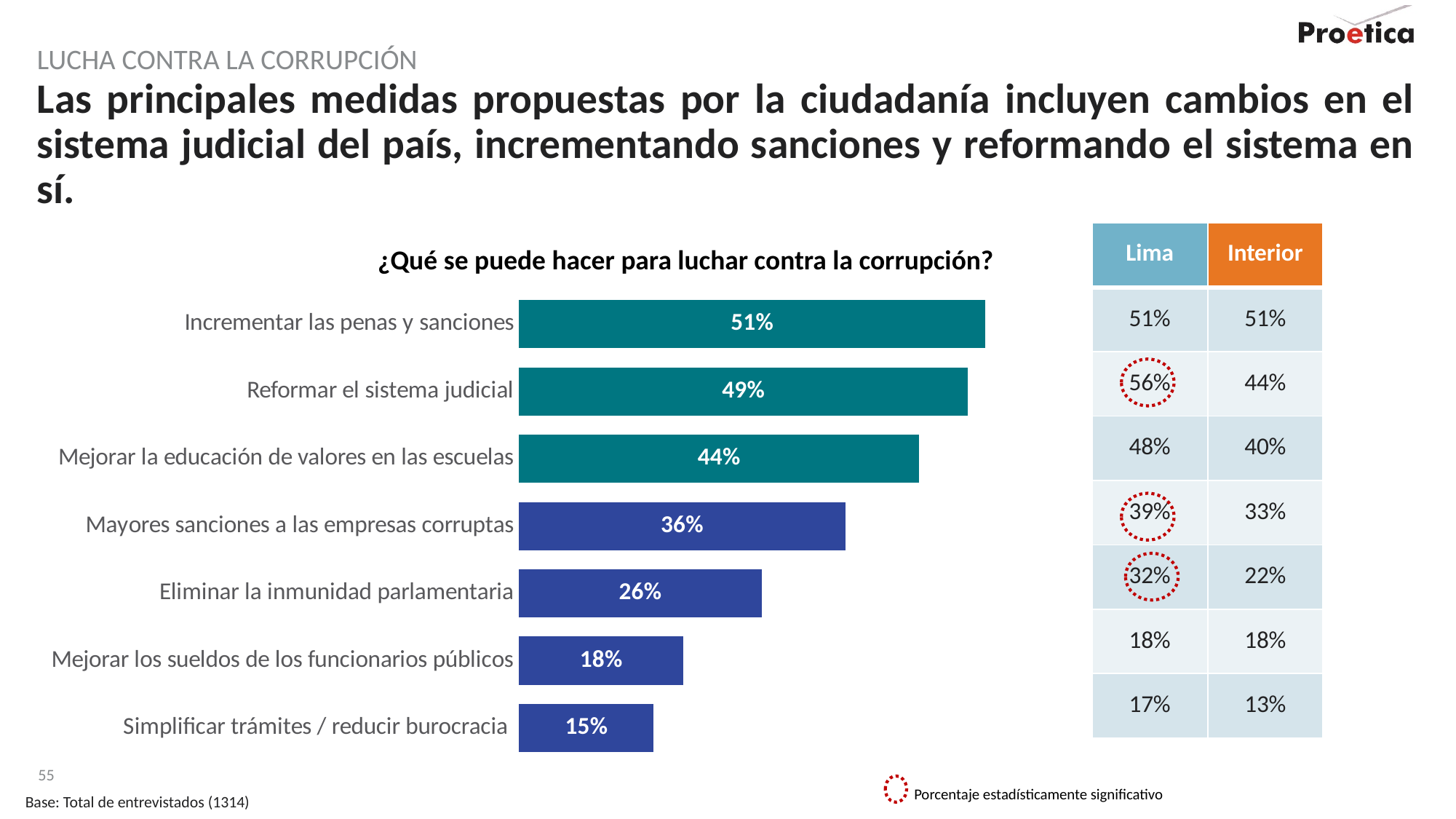
What is the title of the chart? ¿Qué se puede hacer para luchar contra la corrupción? Which category has the lowest value? Simplificar trámites / reducir burocracia Which is larger, "Eliminar la inmunidad parlamentaria" or "Mejorar los sueldos de los funcionarios públicos"? Eliminar la inmunidad parlamentaria What is the difference between "Mejorar la educación de valores en las escuelas" and "Mayores sanciones a las empresas corruptas"? 8% What is the value for "Simplificar trámites / reducir burocracia"? 15% Do the values rise or fall going from the top bar to the bottom bar? Fall What kind of chart is shown? Bar chart Which category has the highest value? Incrementar las penas y sanciones What is the value for "Reformar el sistema judicial"? 49% What is the value for "Incrementar las penas y sanciones"? 51% How many categories does the chart show? 7 What is the value for "Eliminar la inmunidad parlamentaria"? 26%